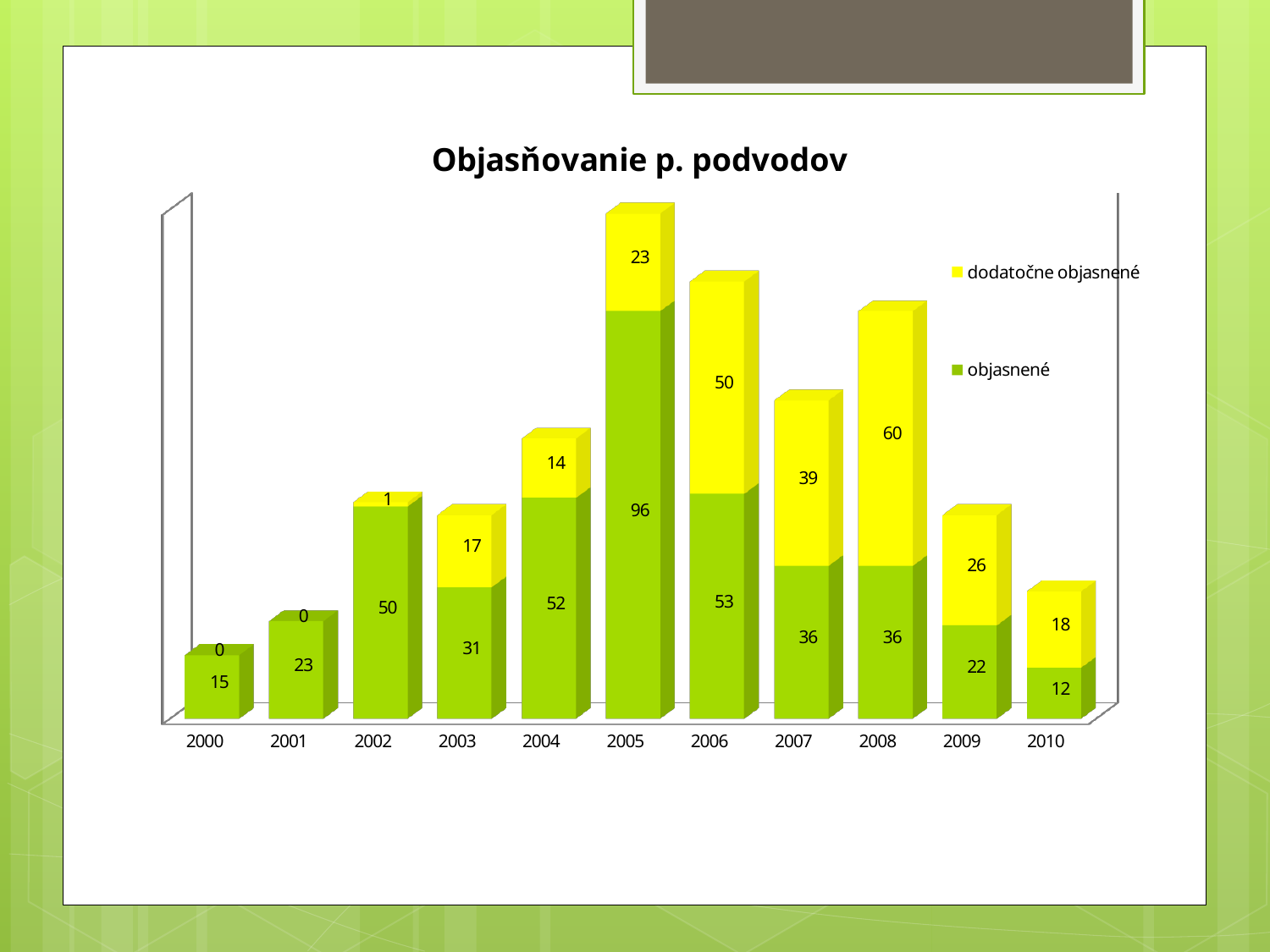
Which year has the highest value for 'objasnené'? 2005 What is the total of the stacked bar for 2006? 103 What is the difference between 'objasnené' in 2005 and 'objasnené' in 2006? 43 How many years are shown on the x axis? 11 Which year has the lowest value for 'objasnené'? 2010 What is the value of 'objasnené' for 2010? 12 Which is larger: 'dodatočne objasnené' in 2007 or 'dodatočne objasnené' in 2009? 2007 How many series does the legend list? 2 What is the value of 'dodatočne objasnené' for 2008? 60 Which year has the highest value for 'dodatočne objasnené'? 2008 What is the total of the stacked bar for 2003? 48 What is the value of 'objasnené' for 2005? 96